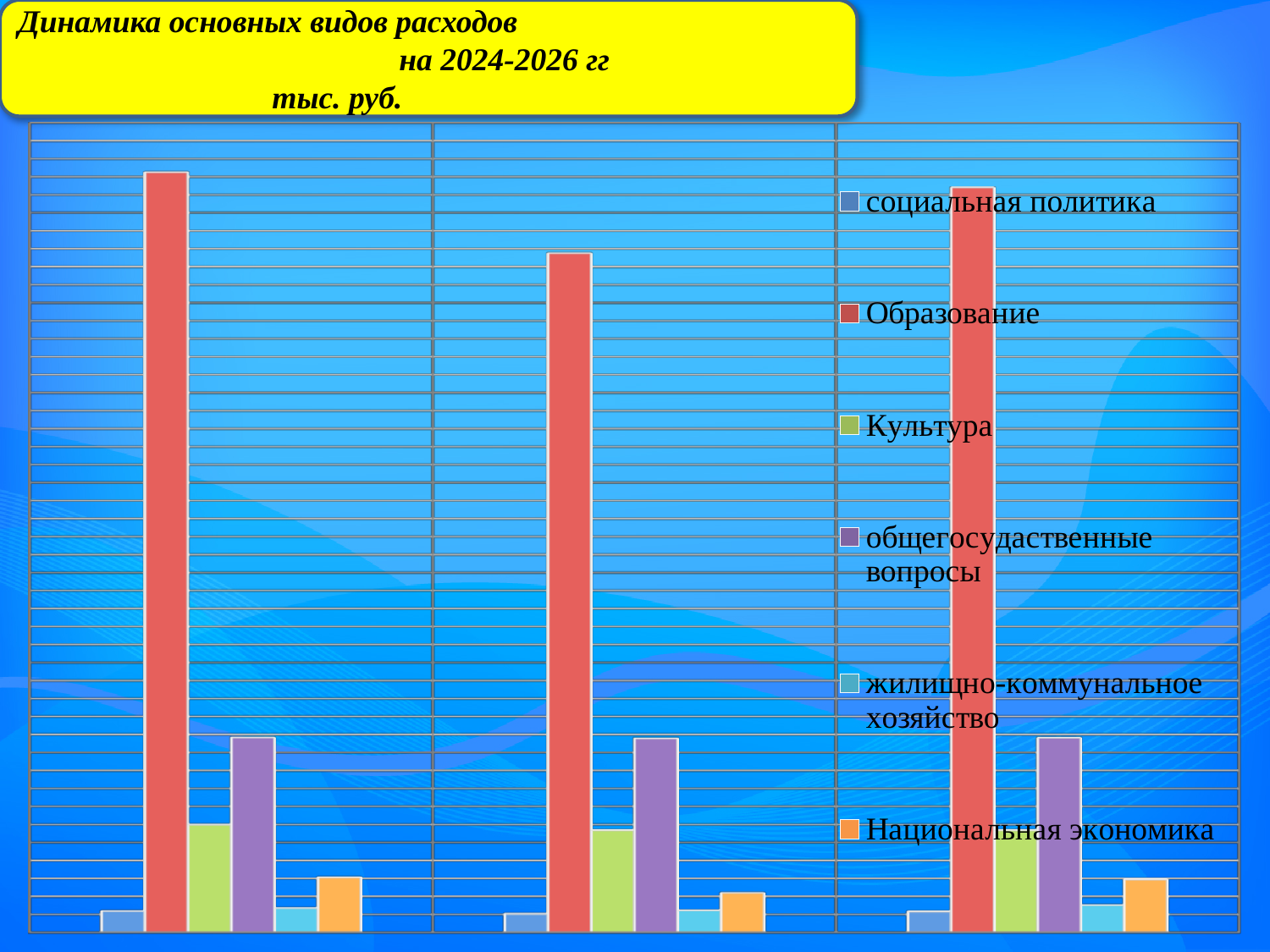
Which series has the tallest bar in every group? Образование What unit of measurement is stated in the chart title? тыс. руб. Is the Образование bar in the middle group taller or shorter than the Образование bar in the left group? shorter In the left group of bars, which is larger: Образование or Культура? Образование In the middle group of bars, which is larger: Культура or Национальная экономика? Культура How many series does the legend list? 6 Which series is shown in red in the legend? Образование How many groups of bars are plotted on the chart? 3 What kind of chart is shown on the slide? bar chart